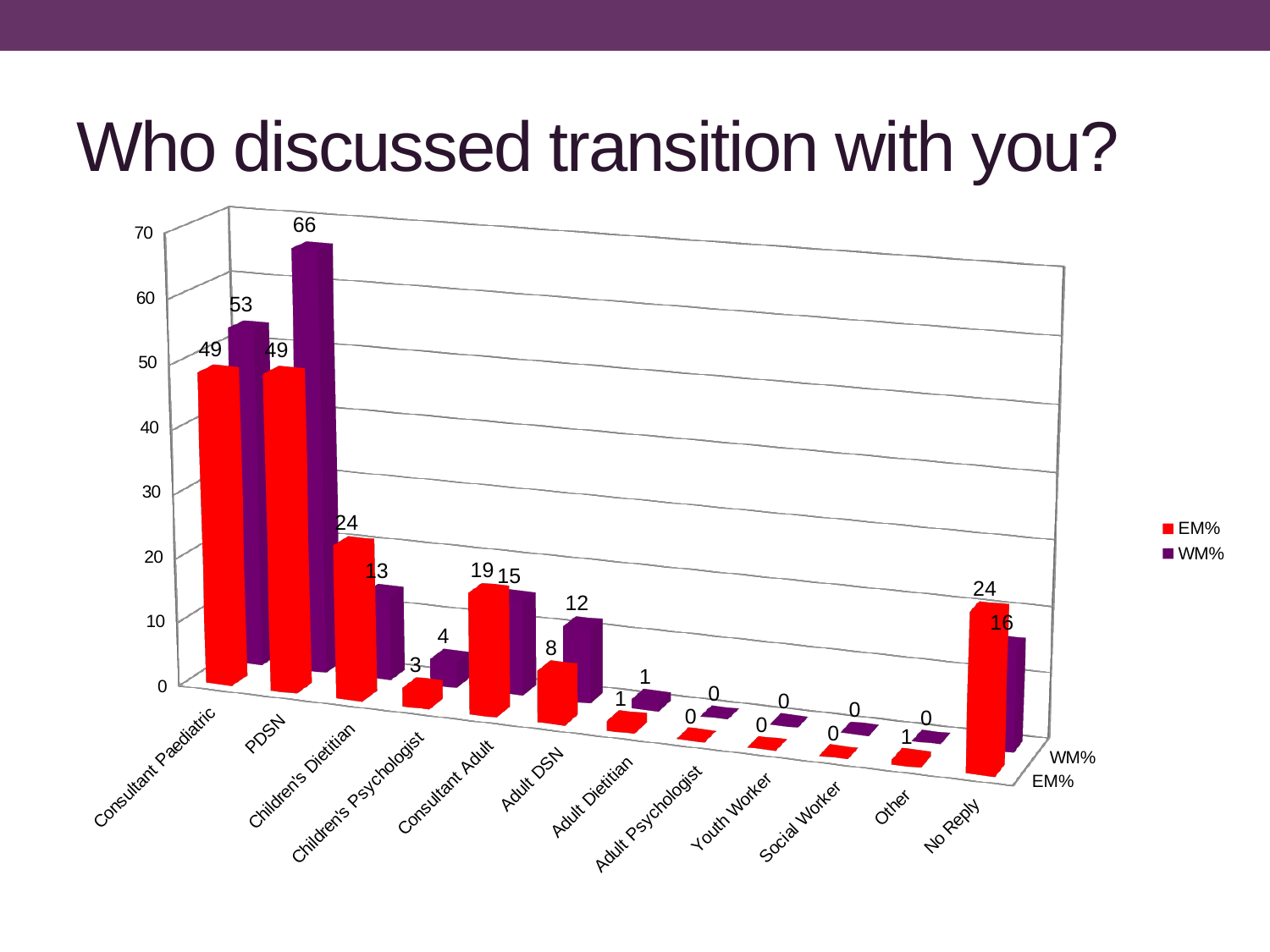
What is the WM% value for PDSN? 66 What is the title of the chart? Who discussed transition with you? Which is larger for Children's Dietitian, the EM% value or the WM% value? EM% What is the difference between the WM% and EM% values for PDSN? 17 What is the EM% value for Consultant Paediatric? 49 What is the EM% value for No Reply? 24 What kind of chart is shown on the slide? Bar chart How many series does the legend list? 2 What is the WM% value for Adult DSN? 12 Which is larger for Consultant Adult, the EM% value or the WM% value? EM% How many categories are shown on the x axis? 12 Which category has the highest WM% value? PDSN